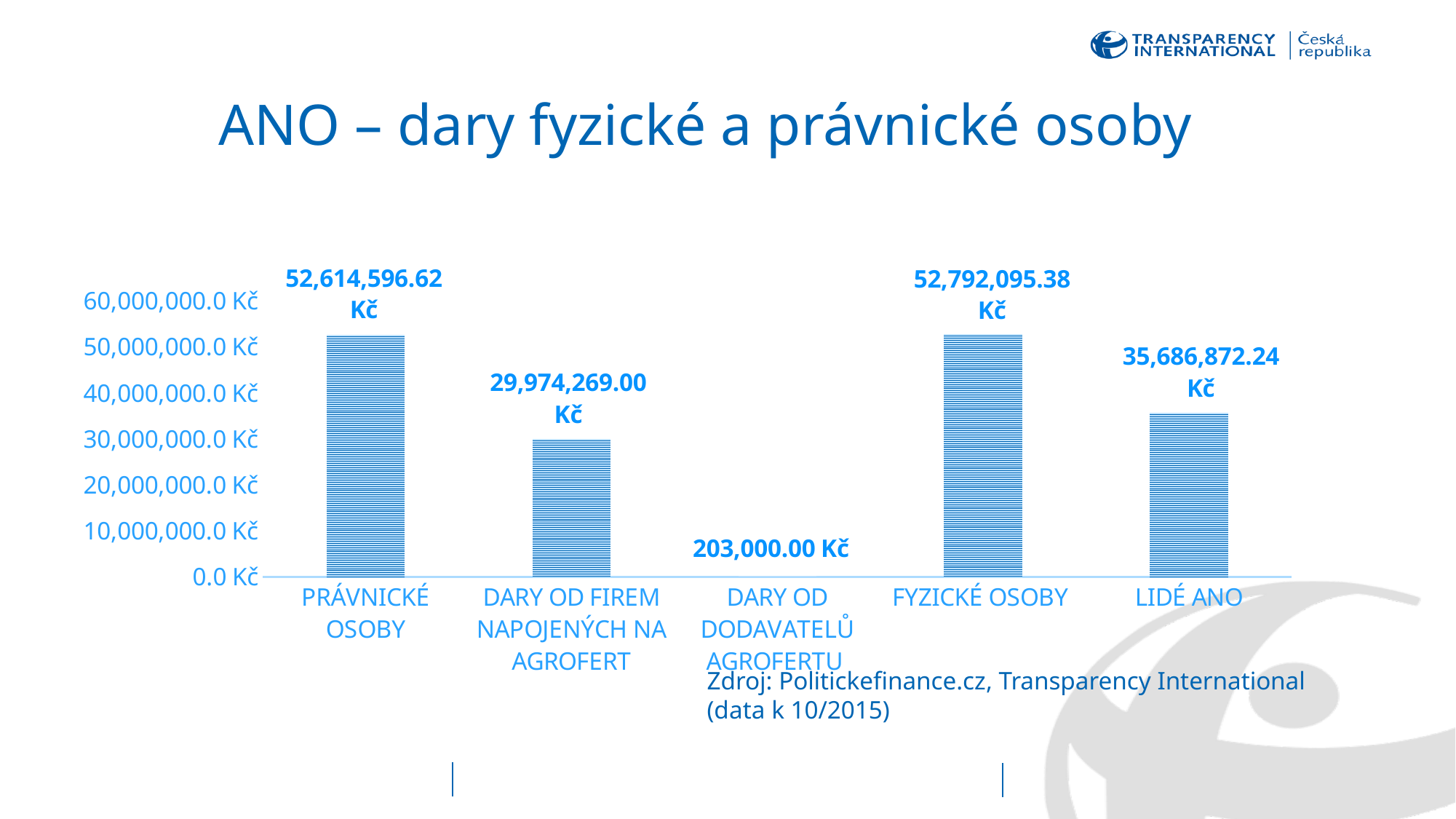
What is the value for DARY OD DODAVATELŮ AGROFERTU? 203,000.00 Kč Is the value for LIDÉ ANO greater or less than 30,000,000.0 Kč? greater What is the value for FYZICKÉ OSOBY? 52,792,095.38 Kč What is the value for LIDÉ ANO? 35,686,872.24 Kč What is the value for PRÁVNICKÉ OSOBY? 52,614,596.62 Kč What kind of chart is shown on the slide? bar chart Which category has the lowest value? DARY OD DODAVATELŮ AGROFERTU What is the difference between the values for FYZICKÉ OSOBY and PRÁVNICKÉ OSOBY? 177,498.76 Kč What is the value for DARY OD FIREM NAPOJENÝCH NA AGROFERT? 29,974,269.00 Kč Which category has the highest value? FYZICKÉ OSOBY Which is larger, the value for LIDÉ ANO or the value for DARY OD FIREM NAPOJENÝCH NA AGROFERT? LIDÉ ANO How many categories are shown in the chart? 5